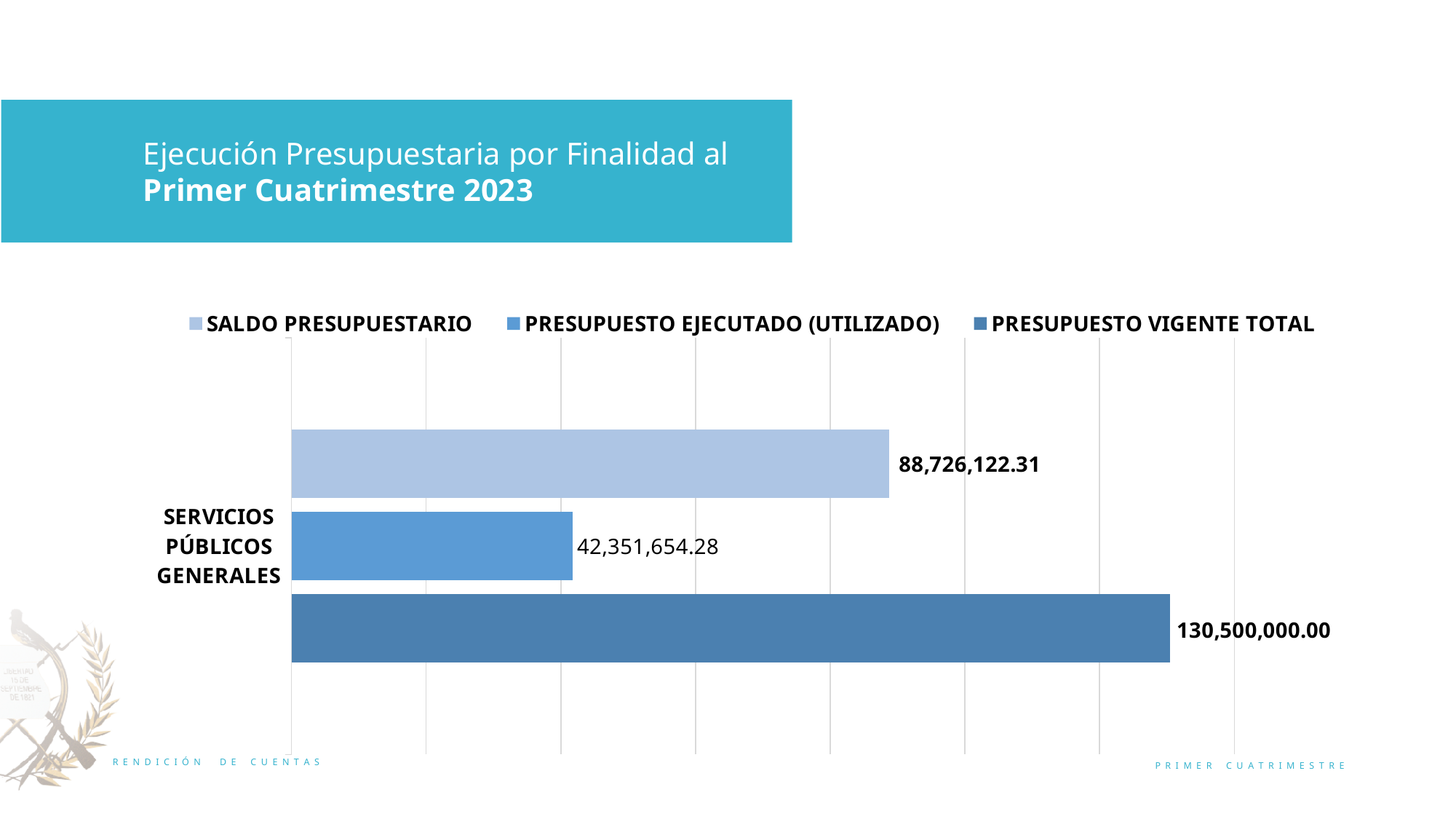
Which series has the highest value for SERVICIOS PÚBLICOS GENERALES? PRESUPUESTO VIGENTE TOTAL What is the value of SALDO PRESUPUESTARIO for SERVICIOS PÚBLICOS GENERALES? 88,726,122.31 What is the value of PRESUPUESTO VIGENTE TOTAL for SERVICIOS PÚBLICOS GENERALES? 130,500,000.00 Which series has the lowest value for SERVICIOS PÚBLICOS GENERALES? PRESUPUESTO EJECUTADO (UTILIZADO) What is the value of PRESUPUESTO EJECUTADO (UTILIZADO) for SERVICIOS PÚBLICOS GENERALES? 42,351,654.28 What is the difference between PRESUPUESTO VIGENTE TOTAL and SALDO PRESUPUESTARIO? 41,773,877.69 What is the difference between SALDO PRESUPUESTARIO and PRESUPUESTO EJECUTADO (UTILIZADO)? 46,374,468.03 How many categories are shown on the chart's vertical axis? 1 What kind of chart is shown on the slide? Bar chart What is the title shown above the chart? Ejecución Presupuestaria por Finalidad al Primer Cuatrimestre 2023 How many series does the legend list? 3 Which is larger, SALDO PRESUPUESTARIO or PRESUPUESTO EJECUTADO (UTILIZADO)? SALDO PRESUPUESTARIO